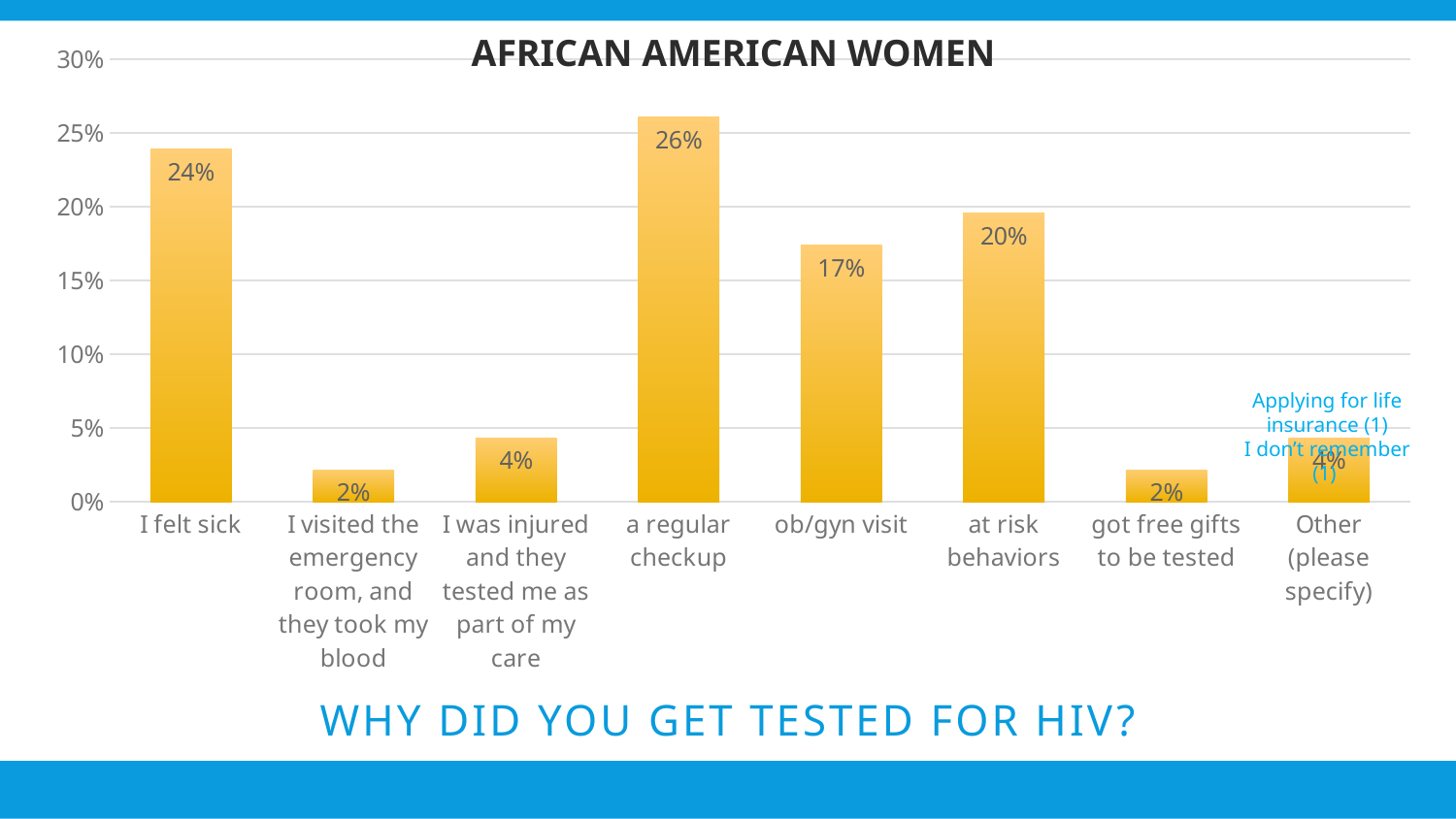
Is the value for 'ob/gyn visit' greater or less than 15%? greater What type of chart is shown on the slide? bar chart What is the value for 'got free gifts to be tested'? 2% Which reason for getting tested has the highest percentage? a regular checkup Which is larger, the value for 'I was injured and they tested me as part of my care' or the value for 'I visited the emergency room, and they took my blood'? I was injured and they tested me as part of my care What is the difference between the percentages for 'a regular checkup' and 'I felt sick'? 2% What percentage of African American women said they got tested for HIV because of a regular checkup? 26% What is the value for 'ob/gyn visit'? 17% What percentage of African American women got tested because they felt sick? 24% What is the value for 'at risk behaviors'? 20% How many reasons (categories) are shown on the x axis of the chart? 8 What is the difference between the percentages for 'at risk behaviors' and 'ob/gyn visit'? 3%